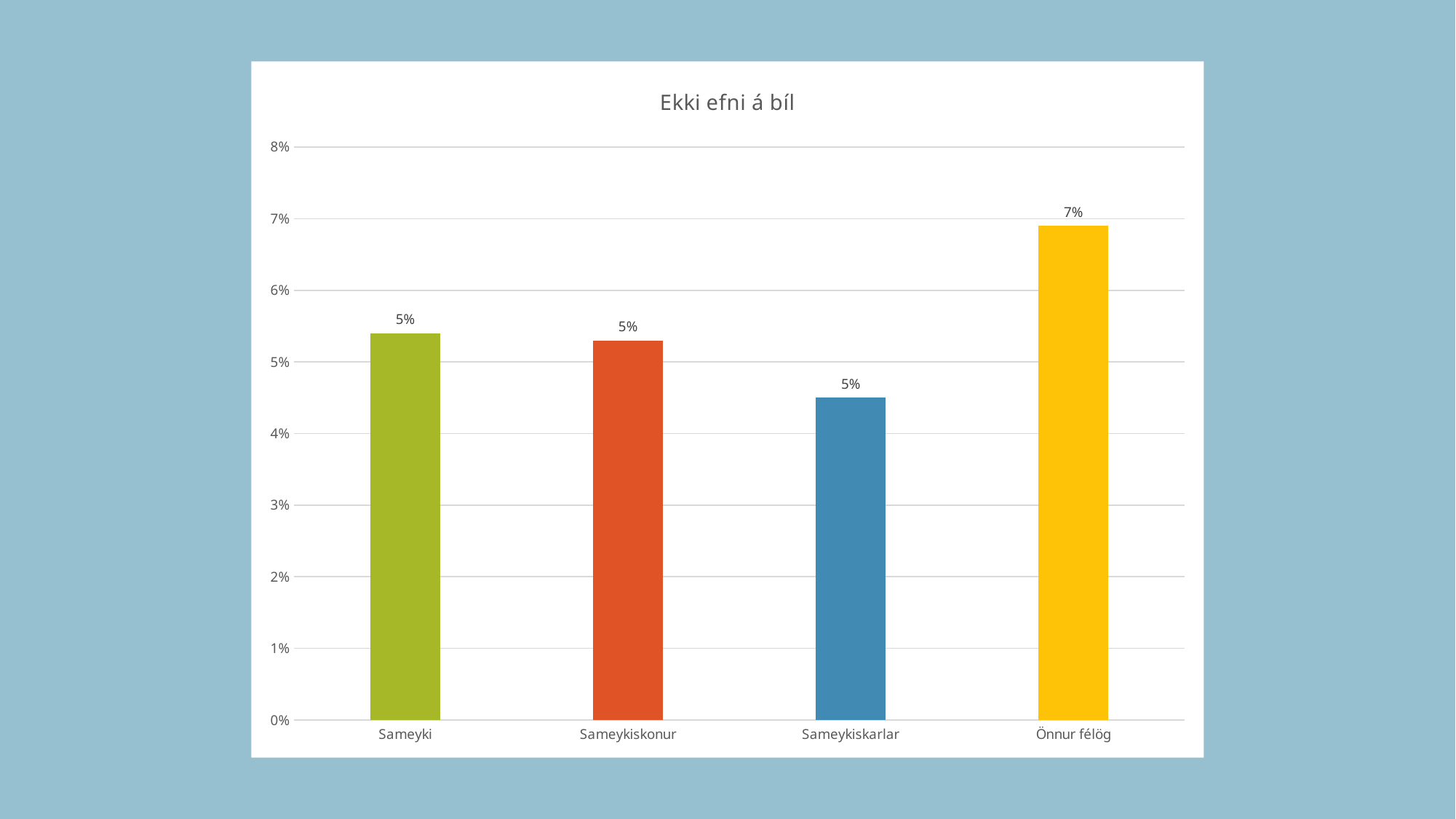
What type of chart is shown on the slide? bar chart Which category has the highest value? Önnur félög Which is larger, the value for Sameyki or the value for Sameykiskarlar? Sameyki Is the value for Önnur félög greater or less than 6%? greater What is the title of the chart? Ekki efni á bíl Which category has the lowest value? Sameykiskarlar How many categories are shown on the x axis? 4 What is the value for Sameyki? 5% What is the value for Sameykiskarlar? 5% What is the value for Önnur félög? 7% What colour is the bar for Önnur félög? yellow Is the value for Sameykiskarlar greater or less than 5%? less